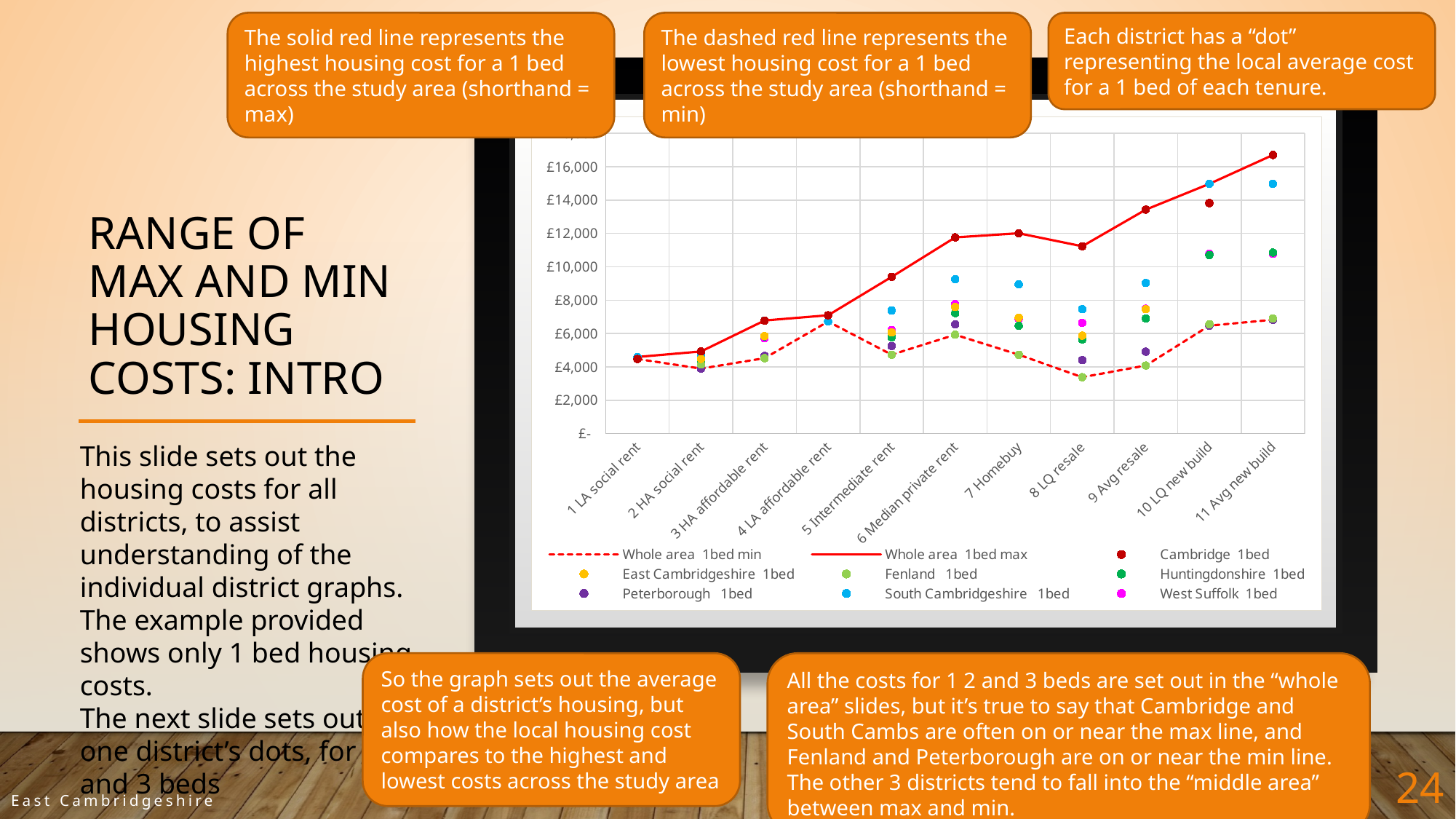
Is the value of the Whole area 1bed max line at 11 Avg new build greater or less than £16,000? greater Which legend entry is represented by the dashed red line? Whole area 1bed min Is the South Cambridgeshire 1bed value at 6 Median private rent greater or less than £8,000? greater What kind of chart is shown on the slide? line chart How many categories are shown along the x axis of the chart? 11 At which category does the Whole area 1bed max line reach its highest value? 11 Avg new build At which category does the Whole area 1bed min line reach its lowest value? 8 LQ resale How many series does the chart's legend list? 9 Is the Cambridge 1bed value at 10 LQ new build greater or less than £12,000? greater On the Whole area 1bed max line, which is larger: the value at 7 Homebuy or the value at 8 LQ resale? 7 Homebuy Does the Whole area 1bed max line generally rise or fall from 1 LA social rent to 11 Avg new build? rise